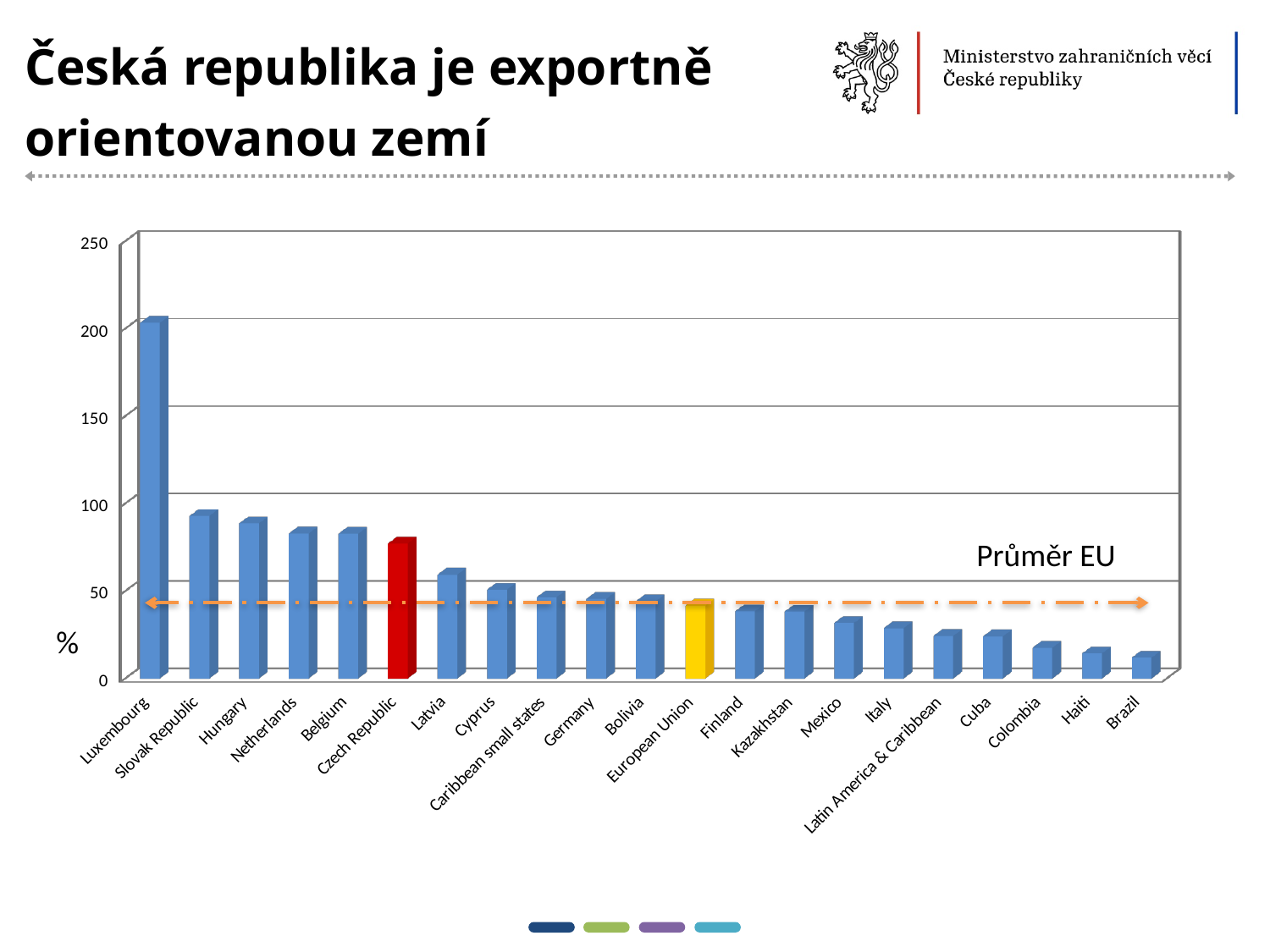
Is the value for Mexico greater or less than 50? less What kind of chart is shown on the slide? bar chart Is the value for Slovak Republic greater or less than 100? less Which category has the highest value in the chart? Luxembourg Which category's bar is coloured red in the chart? Czech Republic Which category has the lowest value in the chart? Brazil Is the value for Luxembourg greater or less than 150? greater What label is written next to the dashed horizontal arrow in the chart? Průměr EU Which has the larger value, Czech Republic or Germany? Czech Republic How many categories are plotted on the x axis of the chart? 21 Do the bar values rise or fall from left to right along the x axis? fall